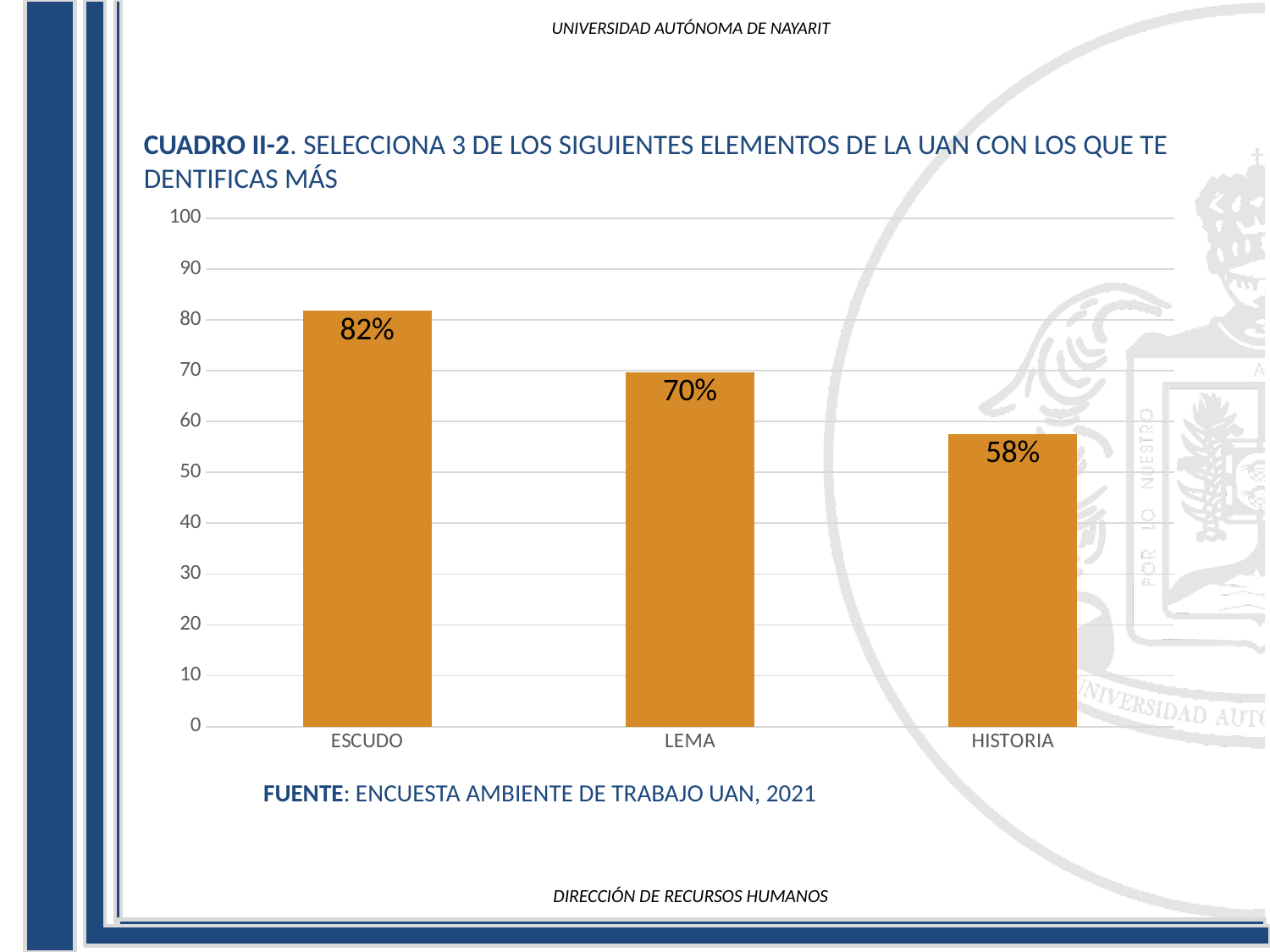
Do the values rise or fall from left to right along the x axis? fall Which category has the lowest value? HISTORIA What is the difference between the values for LEMA and HISTORIA? 12% How many categories are shown on the x axis? 3 What kind of chart is shown on the slide? bar chart What is the difference between the values for ESCUDO and HISTORIA? 24% Is the value for LEMA greater or less than 60? greater Which is larger, the value for LEMA or the value for HISTORIA? LEMA What is the value for HISTORIA? 58% What is the value for ESCUDO? 82% What is the value for LEMA? 70% Which category has the highest value? ESCUDO